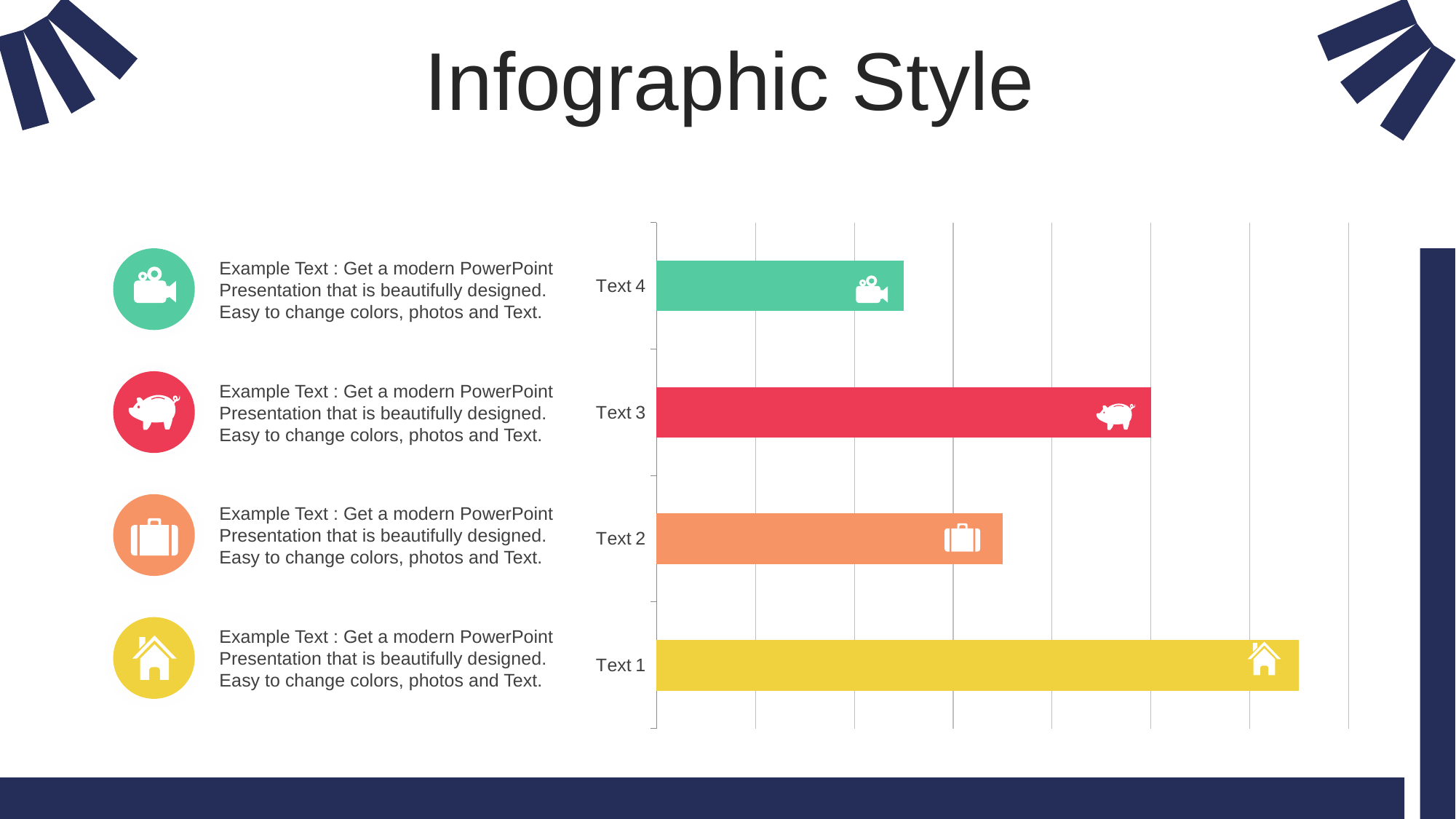
What colour is the bar for Text 1? Yellow What colour is the bar for Text 3? Red What kind of chart is shown on the slide? Bar chart Which category has the second-longest bar in the chart? Text 3 Which category has the longest bar in the chart? Text 1 How many categories does the bar chart show? 4 Which category has the shortest bar in the chart? Text 4 Which bar is longer, Text 2 or Text 4? Text 2 Which bar is longer, Text 3 or Text 2? Text 3 Which bar is longer, Text 1 or Text 3? Text 1